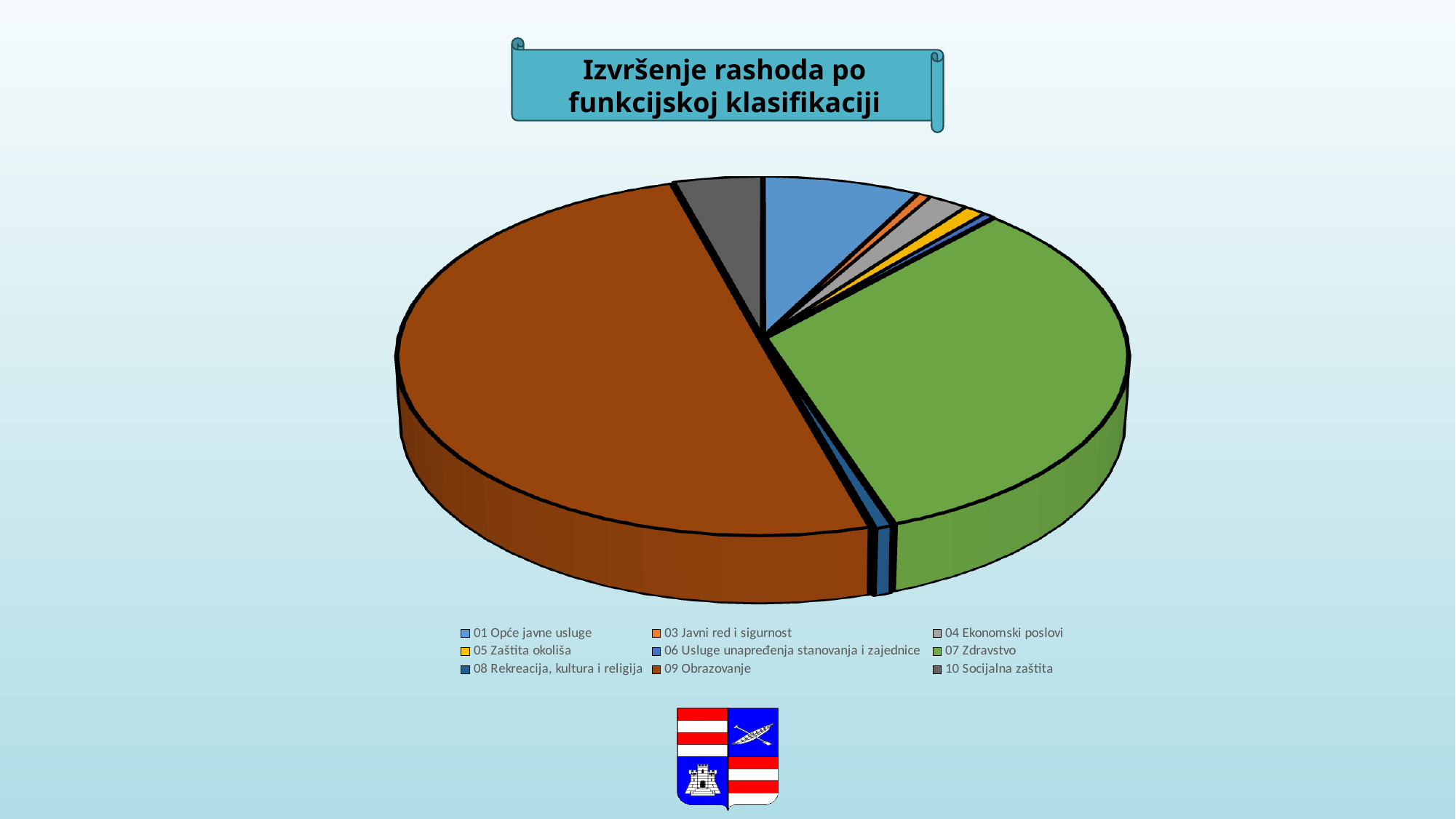
What is the title of the chart? Izvršenje rashoda po funkcijskoj klasifikaciji How many categories does the legend of the pie chart list? 9 Which slice is larger, 09 Obrazovanje or 07 Zdravstvo? 09 Obrazovanje Which category has the second largest slice of the pie? 07 Zdravstvo Which slice is larger, 10 Socijalna zaštita or 04 Ekonomski poslovi? 10 Socijalna zaštita Which slice is larger, 09 Obrazovanje or 10 Socijalna zaštita? 09 Obrazovanje What kind of chart is shown on the slide? Pie chart Which category has the largest slice of the pie? 09 Obrazovanje What colour is the slice for 09 Obrazovanje? Brown